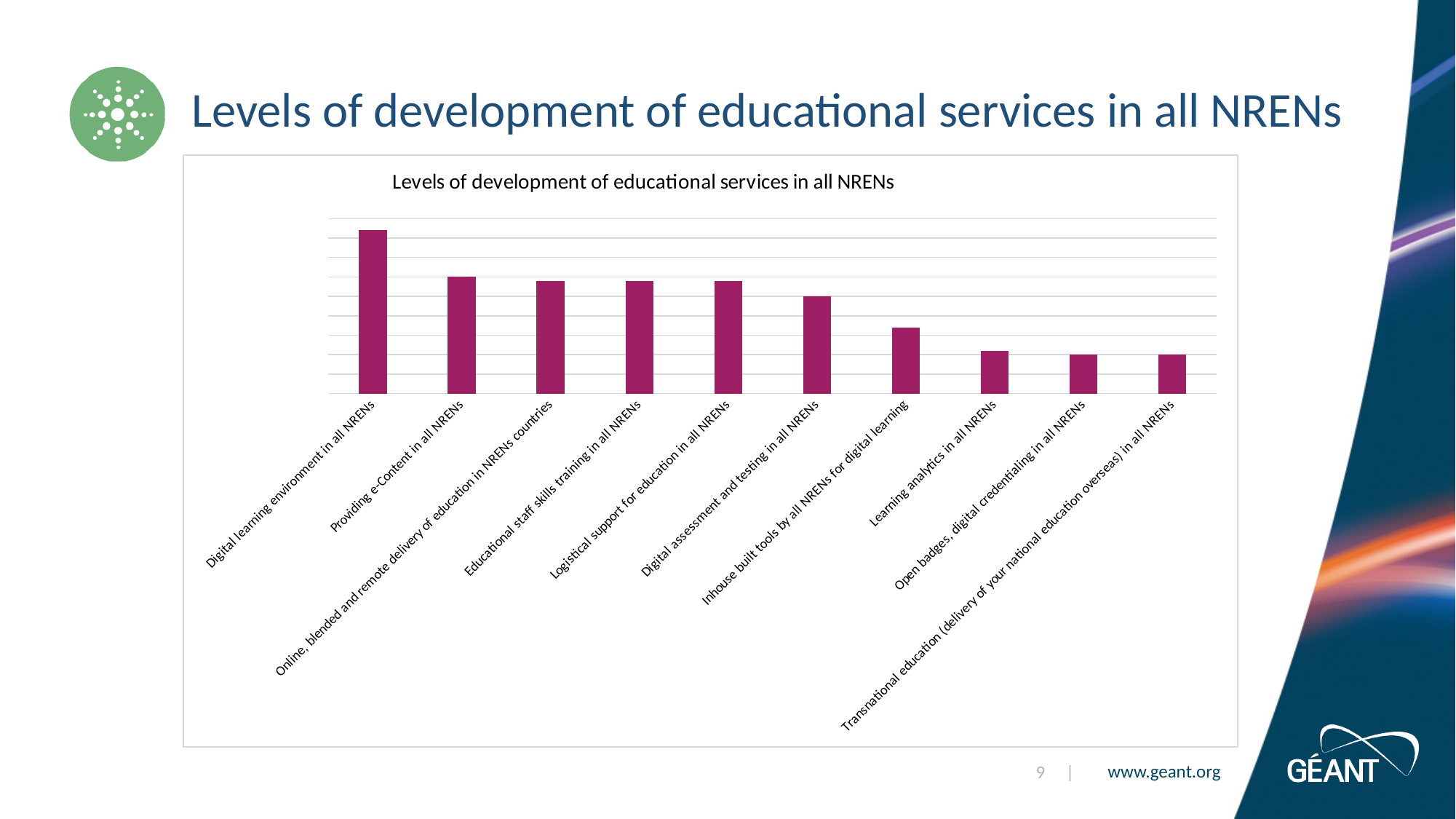
Do the bar values generally rise or fall from left to right across the chart? fall What kind of chart is shown on the slide? bar chart What colour are the bars in the chart? magenta Which is larger: the value for Digital learning environment in all NRENs or the value for Learning analytics in all NRENs? Digital learning environment in all NRENs What is the title of the chart? Levels of development of educational services in all NRENs Which is larger: the value for Providing e-Content in all NRENs or the value for Inhouse built tools by all NRENs for digital learning? Providing e-Content in all NRENs How many categories (bars) does the chart show? 10 Which is larger: the value for Digital assessment and testing in all NRENs or the value for Open badges, digital credentialing in all NRENs? Digital assessment and testing in all NRENs Which category has the highest level of development? Digital learning environment in all NRENs